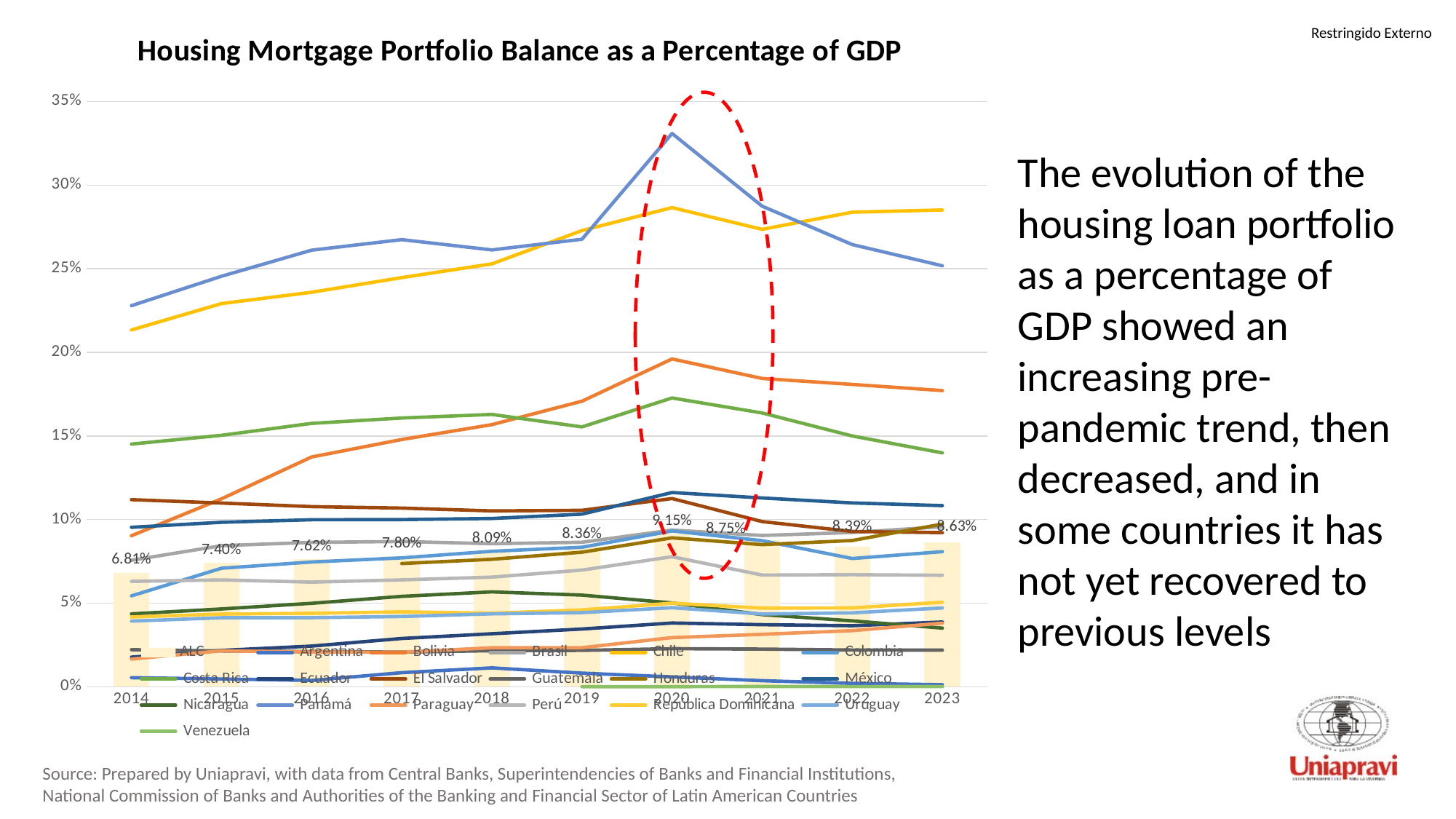
Is the value of the highest line in 2020 greater or less than 30%? greater What is the difference between the ALC values for 2020 and 2021? 0.40 percentage points In which year is the ALC value highest? 2020 What is the ALC value for 2023? 8.63% In which year is the ALC value lowest? 2014 What is the ALC value for 2020? 9.15% How many series does the legend list? 19 How many years are shown on the x axis? 10 Which is larger, the ALC value for 2022 or for 2023? 2023 What is the ALC value for 2014? 6.81% Does the ALC value rise or fall from 2014 to 2020? rise What is the title of the chart? Housing Mortgage Portfolio Balance as a Percentage of GDP